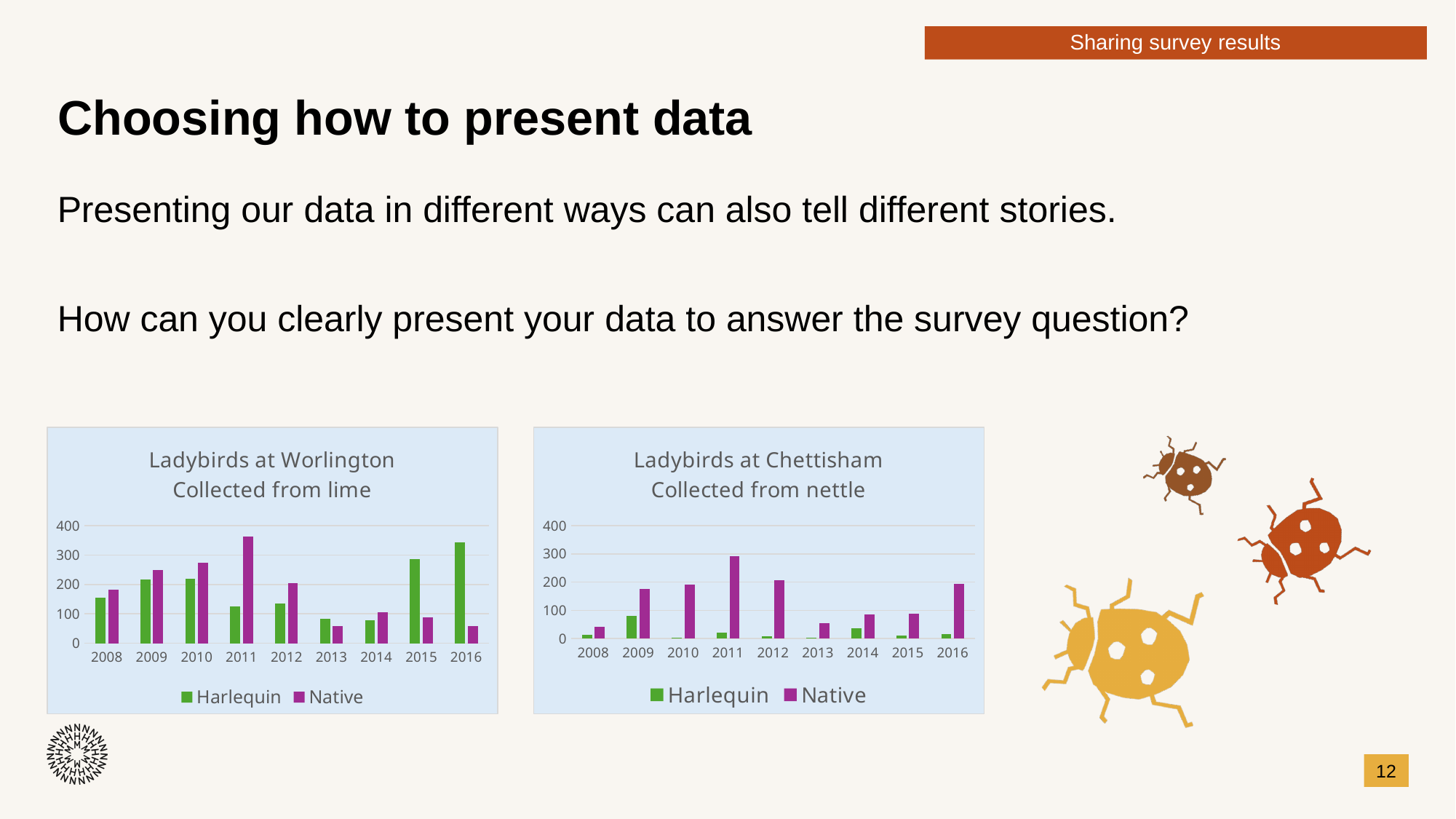
In the 'Ladybirds at Worlington' chart, is the Harlequin value for 2016 greater or less than 300? greater In the 'Ladybirds at Worlington' chart, in 2015, which series has the larger value, Harlequin or Native? Harlequin In the 'Ladybirds at Worlington' chart, is the Native value for 2013 greater or less than 100? less What kind of chart is the 'Ladybirds at Chettisham' chart? bar chart How many years are shown on the x axis of the 'Ladybirds at Chettisham' chart? 9 In the 'Ladybirds at Chettisham' chart, in 2009, which series has the larger value, Harlequin or Native? Native In the 'Ladybirds at Worlington' chart, which year has the highest Harlequin value? 2016 How many series does the legend of the 'Ladybirds at Worlington' chart list? 2 In the 'Ladybirds at Chettisham' chart, is the Native value for 2011 greater or less than 200? greater In the 'Ladybirds at Worlington' chart, which year has the highest Native value? 2011 In the 'Ladybirds at Chettisham' chart, which year has the highest Native value? 2011